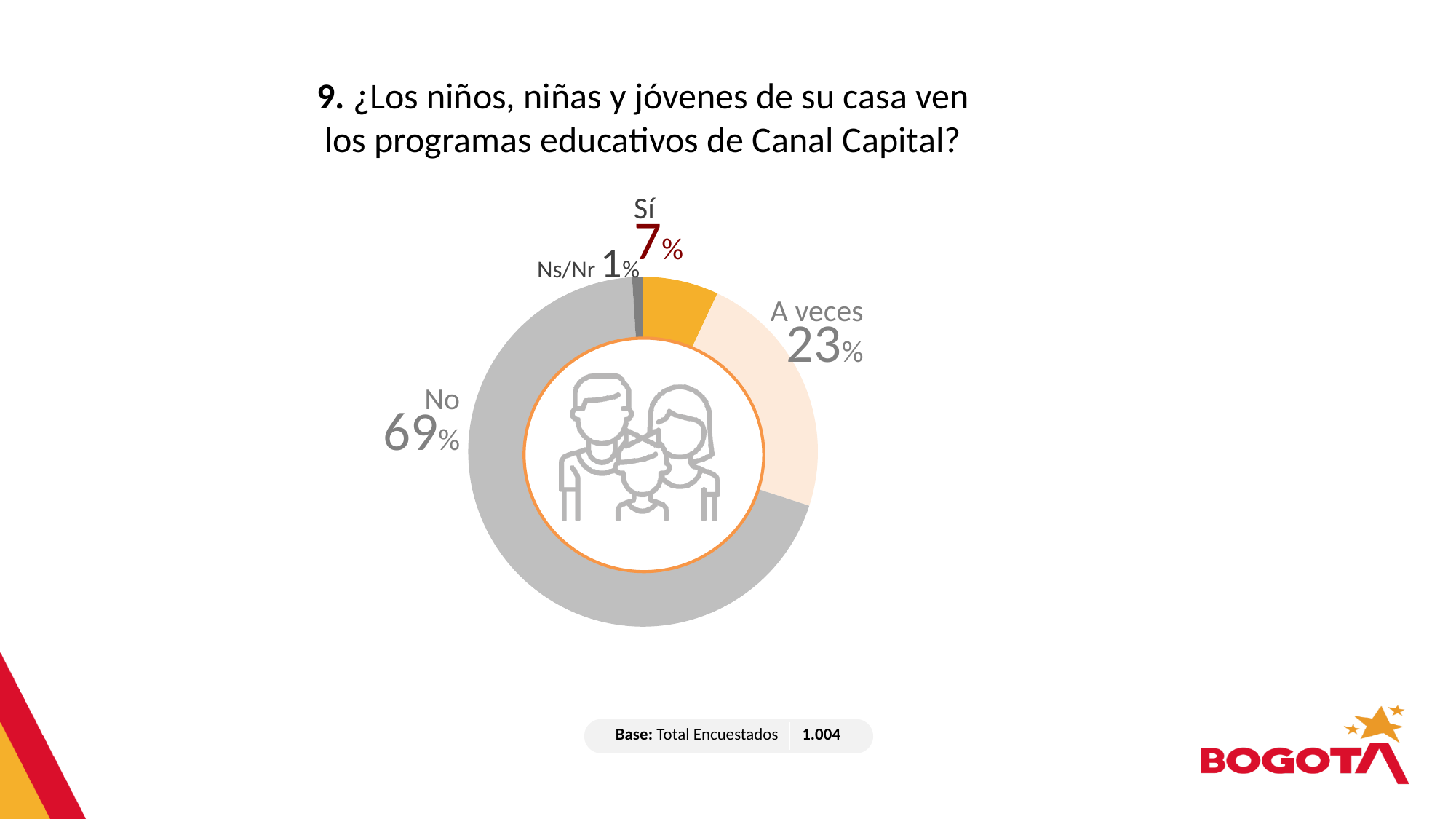
How many response categories are shown in the chart? 4 What percentage of respondents answered "Ns/Nr"? 1% What is the difference in percentage points between "No" and "A veces"? 46 Which is larger, the share for "Sí" or the share for "A veces"? A veces What percentage of respondents answered "Sí"? 7% What colour is the "Sí" slice of the chart? Orange/yellow What percentage of respondents answered "A veces"? 23% What is the base (total number of respondents) shown on the slide? 1.004 What kind of chart is shown on the slide? Pie chart (donut) Which response has the largest share of the chart? No What percentage of respondents answered "No"? 69% Which response has the smallest share of the chart? Ns/Nr